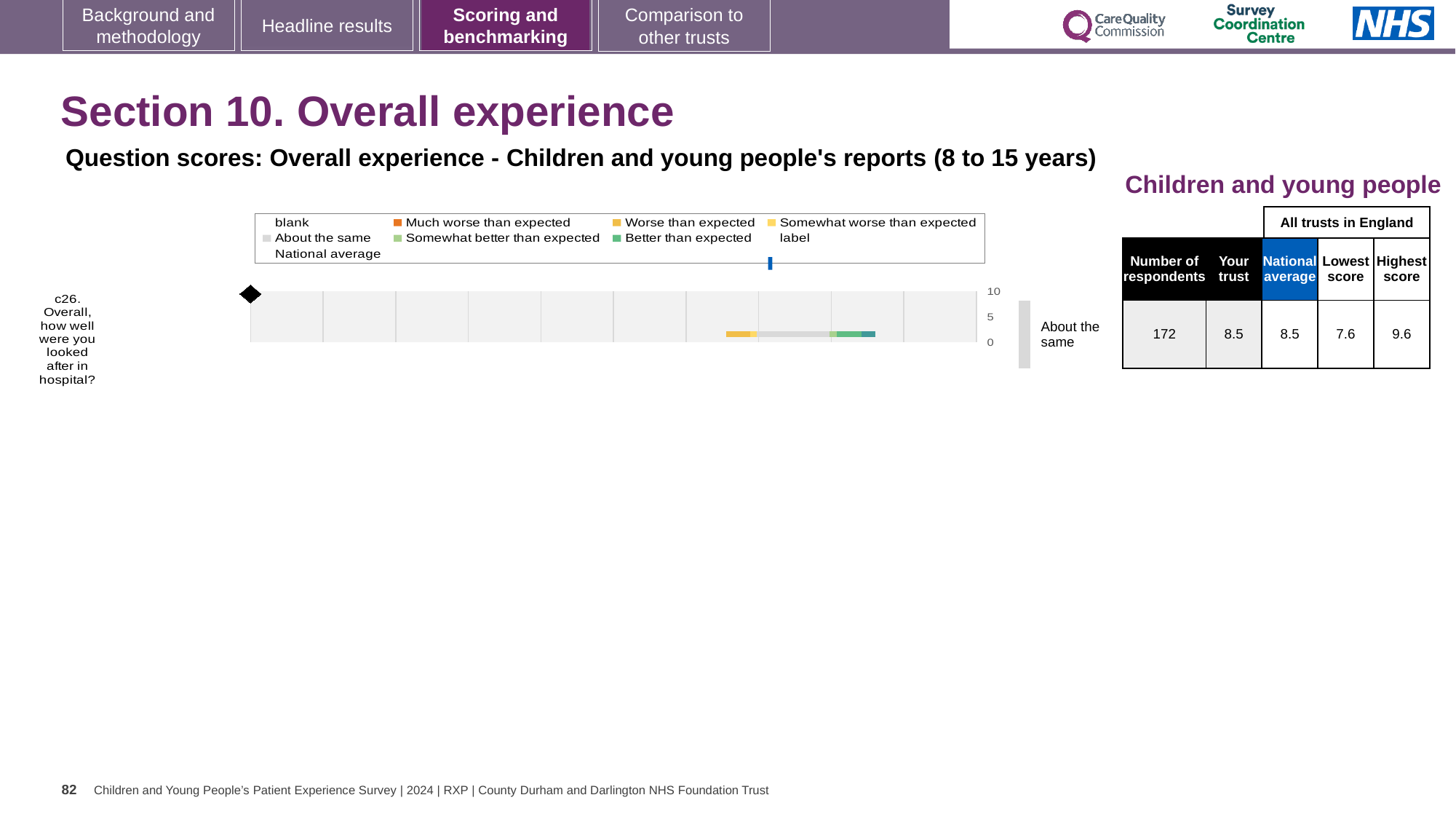
What is the National average score for question c26 in the table? 8.5 What is the highest value shown on the chart's score axis? 10 What is the Highest score among all trusts in England for question c26? 9.6 How many survey questions are plotted in the chart on the slide? 1 How many respondents answered question c26? 172 What is the difference between the Highest score and the Lowest score for question c26? 2.0 Which question is plotted in the chart on the slide? c26. Overall, how well were you looked after in hospital? Is the 'Your trust' score for question c26 larger than, smaller than, or equal to the National average? equal What is the 'Your trust' score for question c26 in the table? 8.5 What kind of chart is shown on the slide for question c26? bar chart What is the Lowest score among all trusts in England for question c26? 7.6 What benchmark category label is shown next to the bar for question c26? About the same